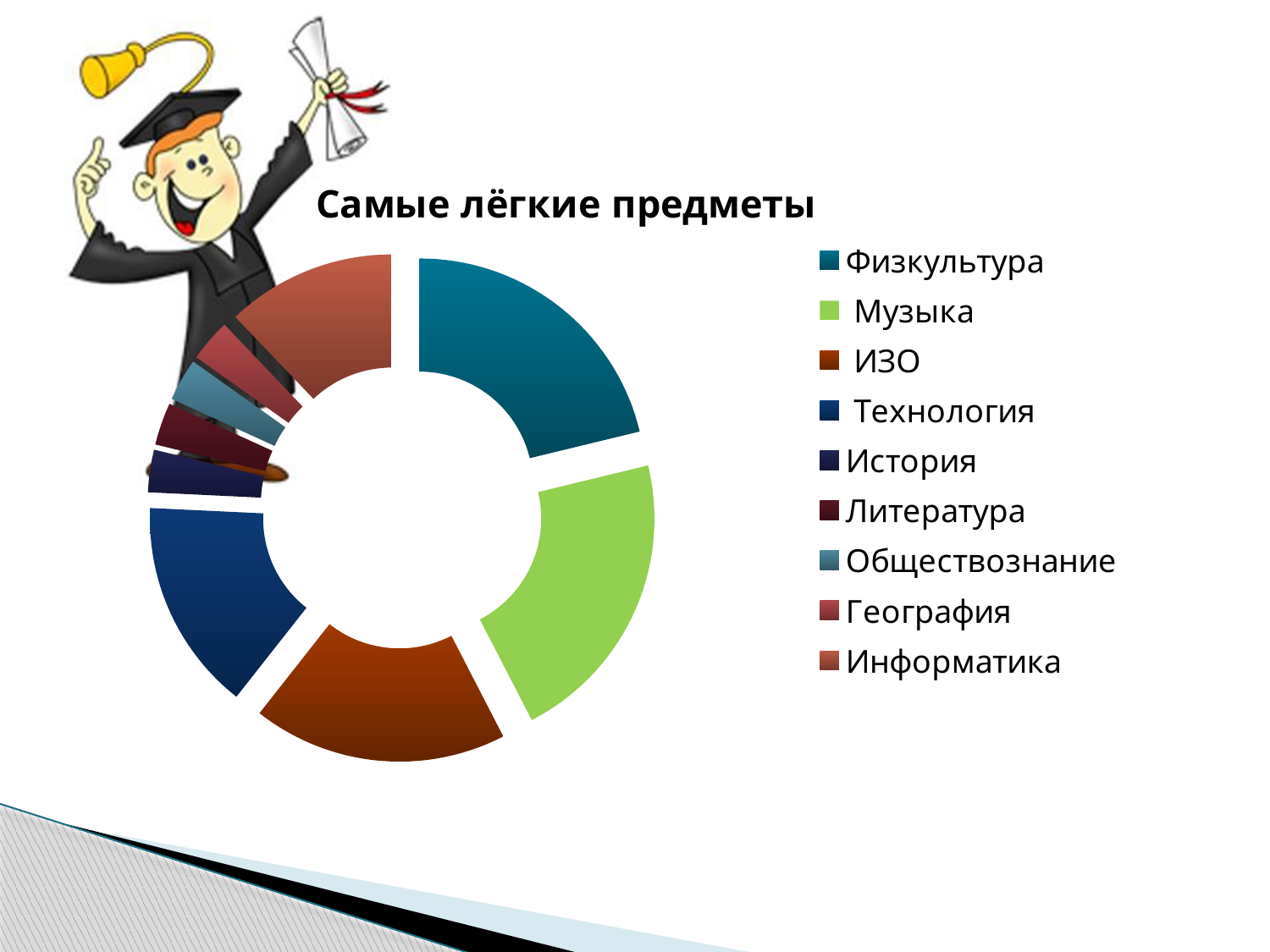
Which is larger in the chart: the slice for ИЗО or the slice for Литература? ИЗО What kind of chart is shown on the slide? Doughnut (pie) chart What is the title of the chart? Самые лёгкие предметы What colour is the slice for Музыка in the chart? Green Which legend entry is listed first in the chart's legend? Физкультура Which is larger in the chart: the slice for Информатика or the slice for История? Информатика Which is larger in the chart: the slice for Физкультура or the slice for История? Физкультура How many categories (subjects) does the chart's legend list? 9